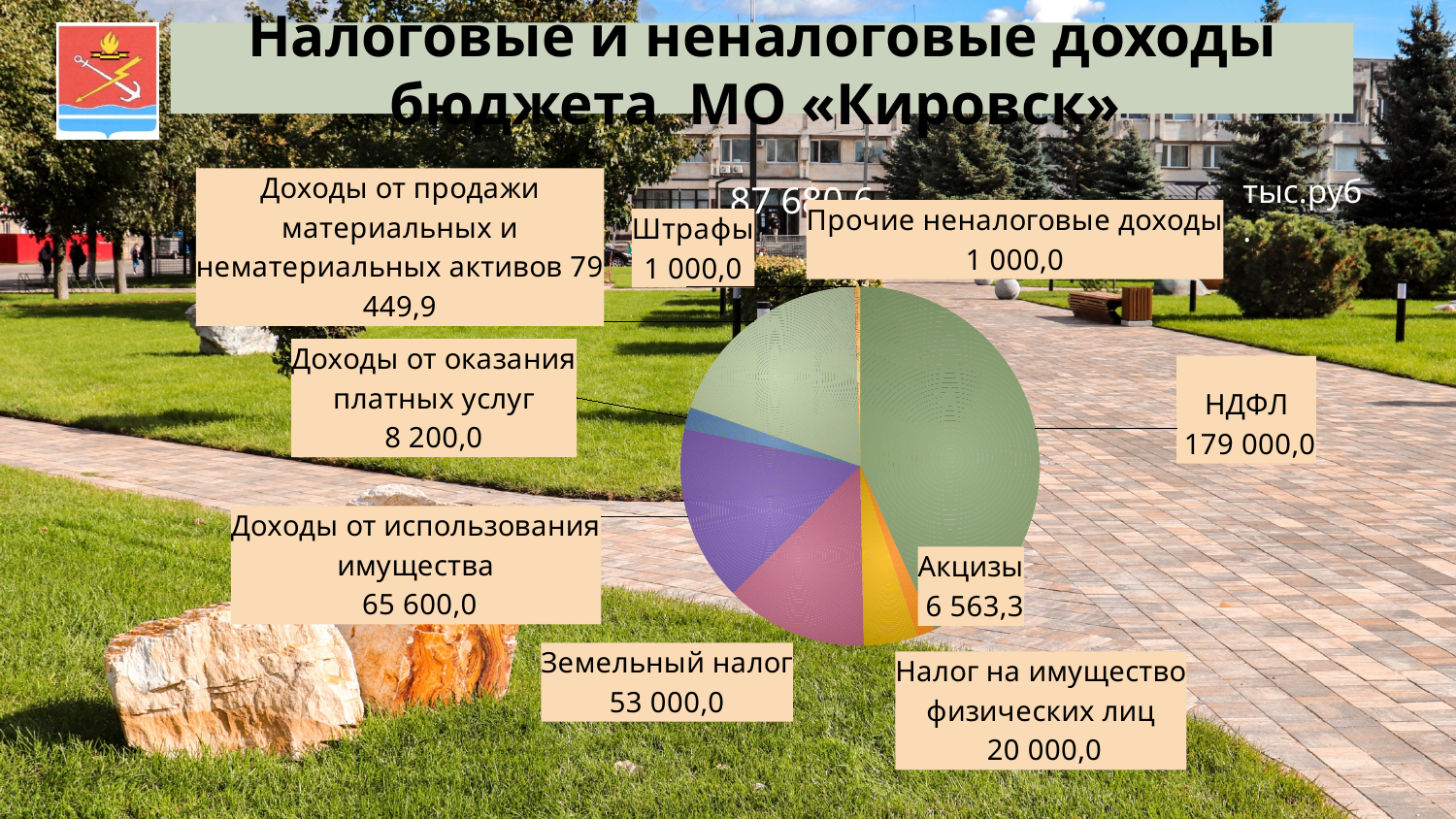
Which is larger: Земельный налог or Доходы от использования имущества? Доходы от использования имущества What is the value for НДФЛ? 179 000,0 What is the value for Акцизы? 6 563,3 Which category has the largest value in the pie chart? НДФЛ What is the difference between НДФЛ and Земельный налог? 126 000,0 What is the difference between Налог на имущество физических лиц and Акцизы? 13 436,7 What is the value for Доходы от оказания платных услуг? 8 200,0 What is the value for Земельный налог? 53 000,0 In what units are the values on the slide given? тыс.руб. What is the value for Штрафы? 1 000,0 What kind of chart is shown on the slide? Pie chart Which is larger: Акцизы or Доходы от оказания платных услуг? Доходы от оказания платных услуг